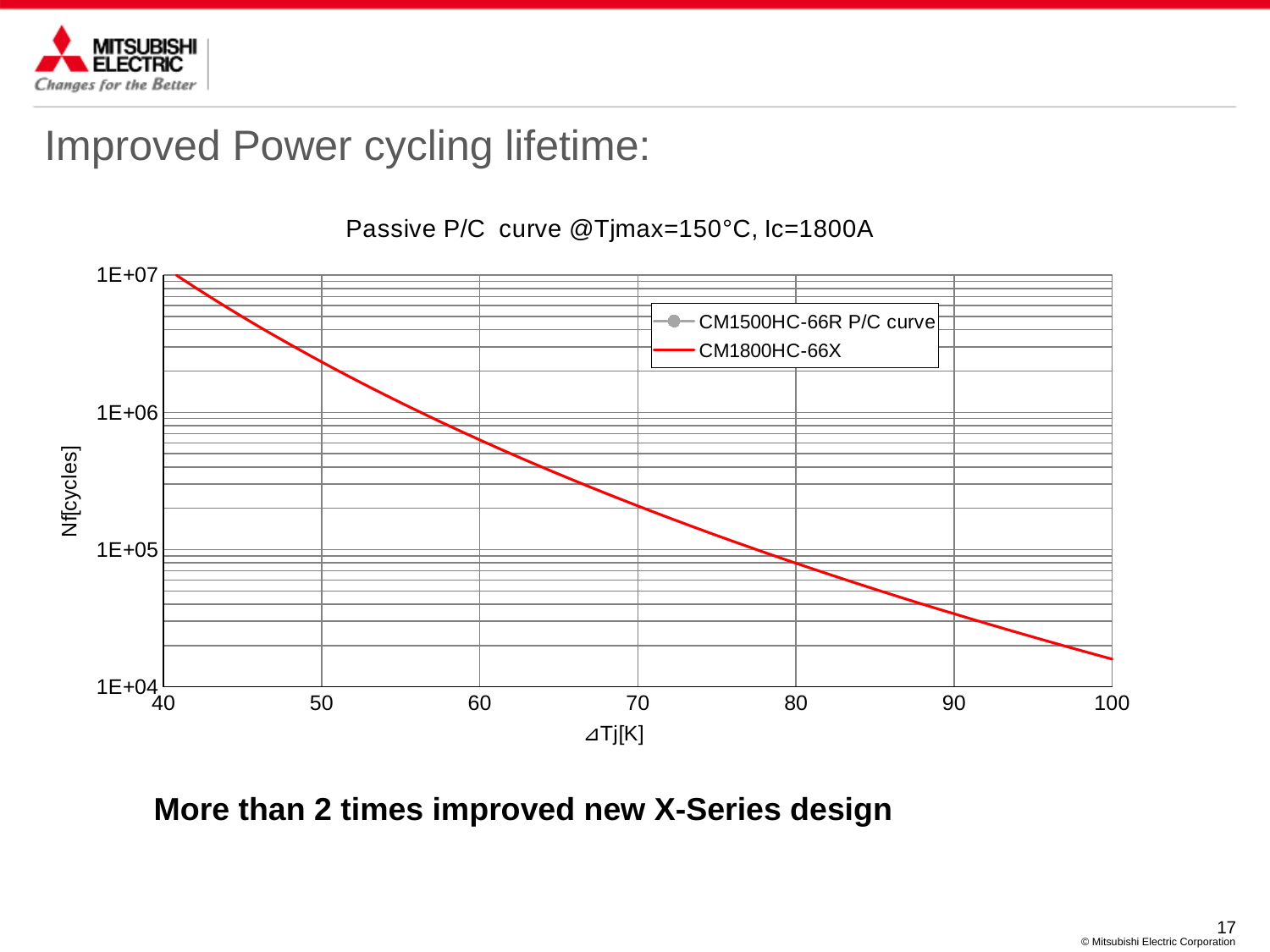
Is the value of the CM1800HC-66X curve at ΔTj=60 K greater or less than 1E+06 cycles? less Is the value of the CM1800HC-66X curve at ΔTj=40 K greater or less than 1E+06 cycles? greater Is the value of the CM1800HC-66X curve at ΔTj=100 K greater or less than 1E+04 cycles? greater What is the title of the chart? Passive P/C curve @Tjmax=150°C, Ic=1800A How many series does the chart legend list? 2 What kind of chart is shown on the slide? line chart What colour is the CM1800HC-66X curve in the chart? red Does the CM1800HC-66X curve rise or fall as ΔTj increases along the x axis? fall